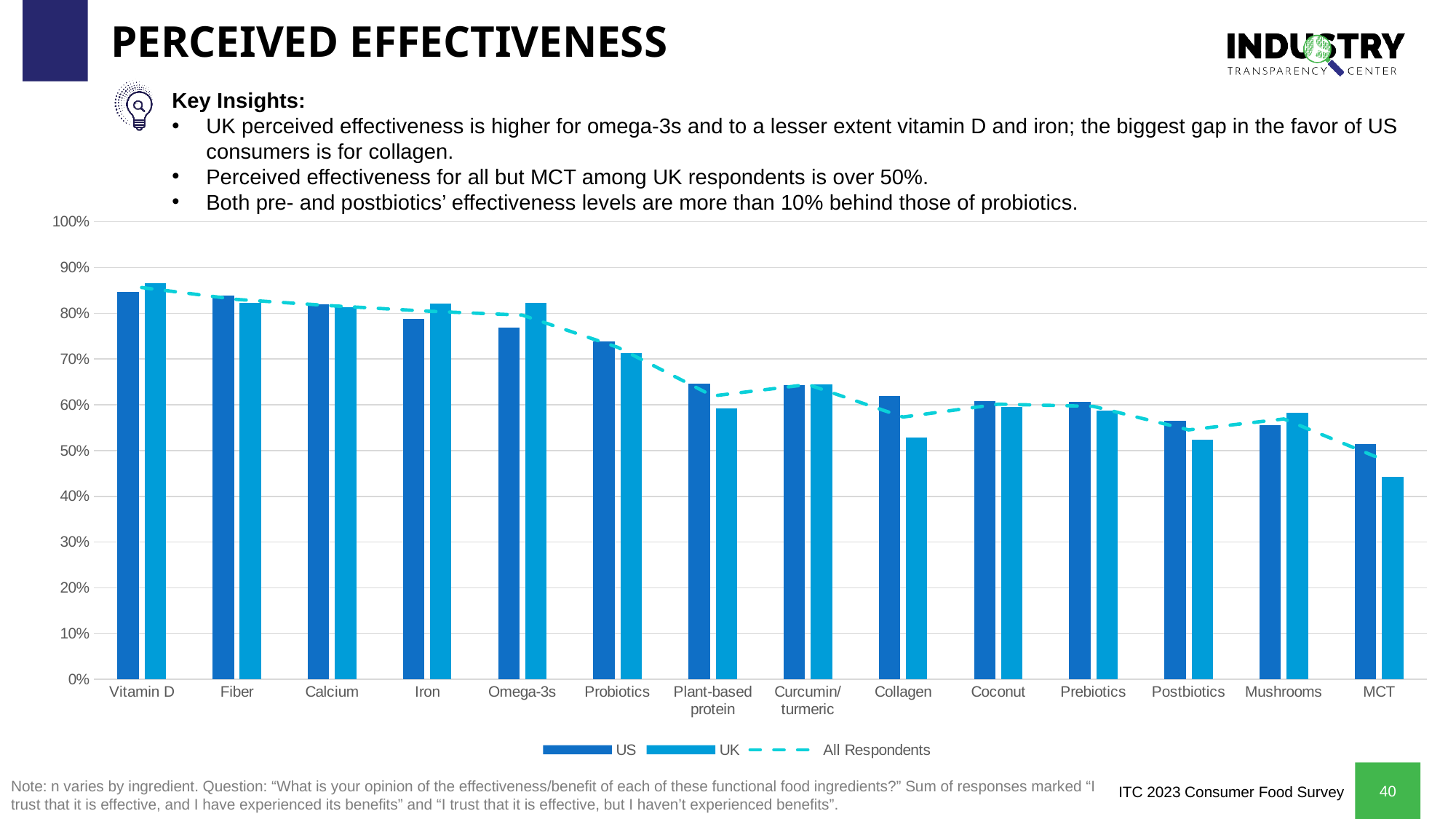
Which ingredient has the highest UK perceived effectiveness? Vitamin D For Collagen, which is larger, the US value or the UK value? US Is the UK value for MCT greater or less than 50%? less Do the values generally rise or fall moving from left to right along the x axis? fall How many ingredient categories are shown on the x axis of the chart? 14 Which ingredient has the lowest US perceived effectiveness? MCT How many series does the chart legend list? 3 Which ingredient has the lowest UK perceived effectiveness? MCT Is the US value for Mushrooms greater or less than 60%? less Is the US value for Vitamin D greater or less than 80%? greater What kind of chart is shown on the slide? combination bar and line chart For Omega-3s, which is larger, the US value or the UK value? UK